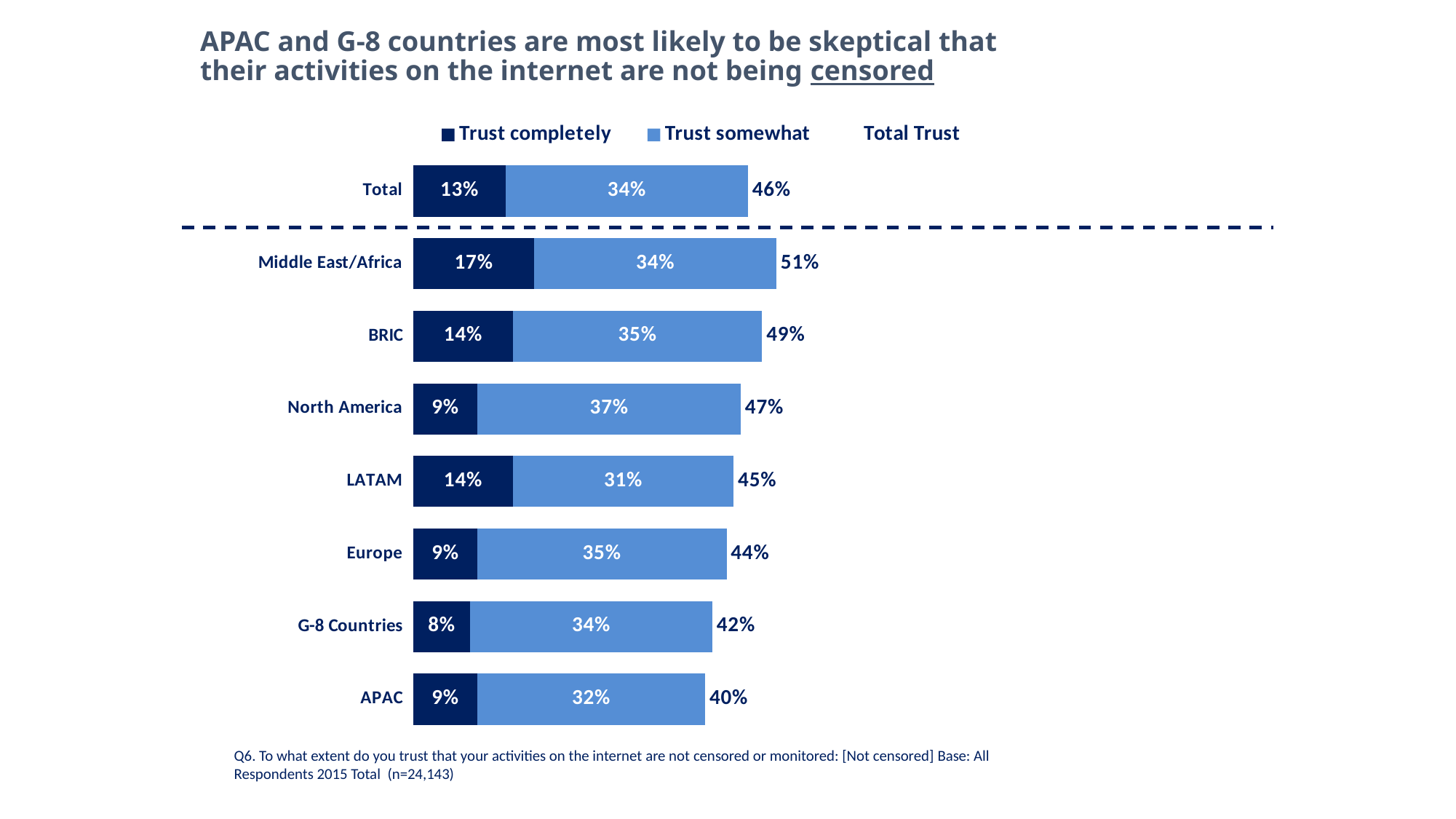
How many region bars are shown below the dashed line? 7 What kind of chart is shown on the slide? Stacked bar chart What is the 'Trust somewhat' value for North America? 37% Which region has the lowest Total Trust value? APAC What is the 'Trust completely' value for Middle East/Africa? 17% How many entries does the legend list? 3 What is the 'Trust somewhat' value for the Total bar? 34% Which region has the highest Total Trust value? Middle East/Africa What is the Total Trust value for APAC? 40% Which is larger, the 'Trust somewhat' value for BRIC or for LATAM? BRIC What is the difference between the Total Trust values for Middle East/Africa and APAC? 11% Which region has the lowest 'Trust completely' value? G-8 Countries